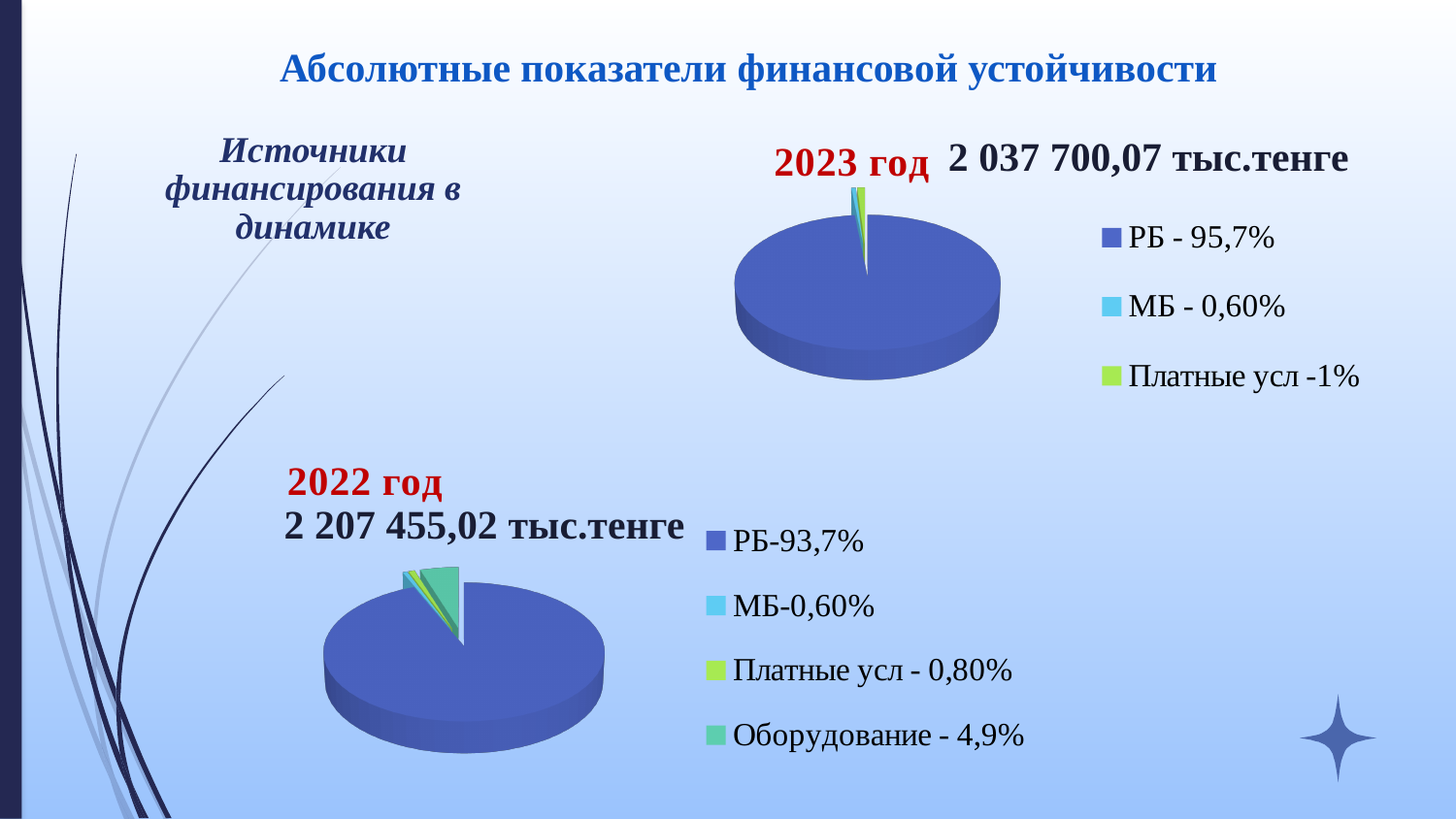
How many categories does the legend of the 2023 год chart list? 3 How many categories does the legend of the 2022 год chart list? 4 What type of chart is used for the 2023 год data? pie chart In the 2023 год chart, what share does РБ have? 95,7% In the 2022 год chart, which is larger: the share of Оборудование or the share of Платные усл? Оборудование In the 2022 год chart, what share does Оборудование have? 4,9% In the 2023 год chart, what share does Платные усл have? 1% In the 2023 год chart, what share does МБ have? 0,60% In the 2022 год chart, which category has the smallest share? МБ In the 2022 год chart, which category has the largest share? РБ In the 2022 год chart, what share does Платные усл have? 0,80% What total amount in тыс.тенге is shown next to the 2023 год chart? 2 037 700,07 тыс.тенге